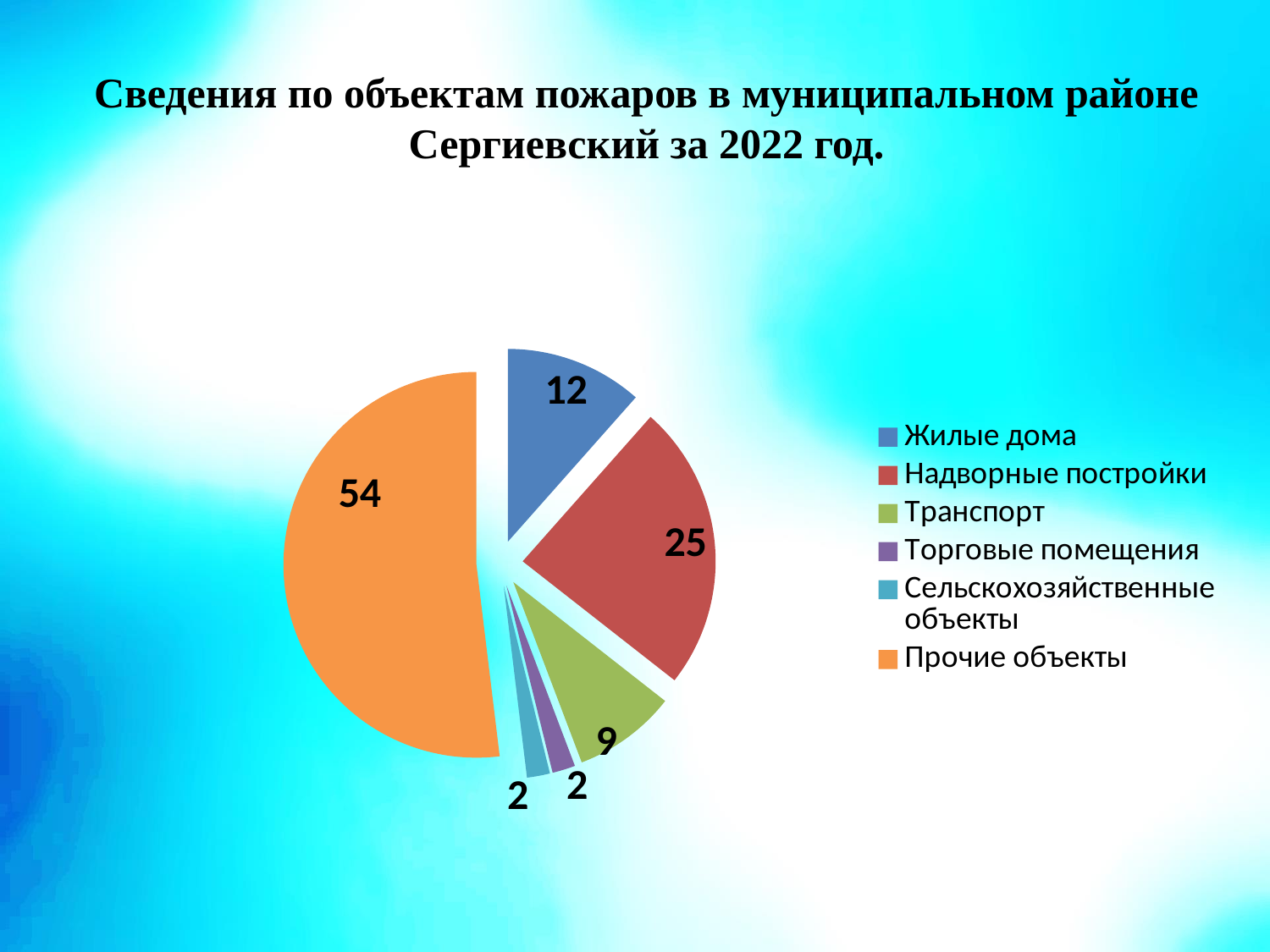
What is the value for Прочие объекты? 54 What is the value for Жилые дома? 12 Which is larger, the value for Жилые дома or the value for Транспорт? Жилые дома What is the difference between the values for Прочие объекты and Надворные постройки? 29 What is the value for Надворные постройки? 25 What colour is the slice for Надворные постройки? Red What is the total of all the values shown in the pie chart? 104 What is the value for Транспорт? 9 What is the value for Торговые помещения? 2 How many categories does the pie chart show? 6 What type of chart is shown on the slide? Pie chart Which category has the largest slice of the pie? Прочие объекты